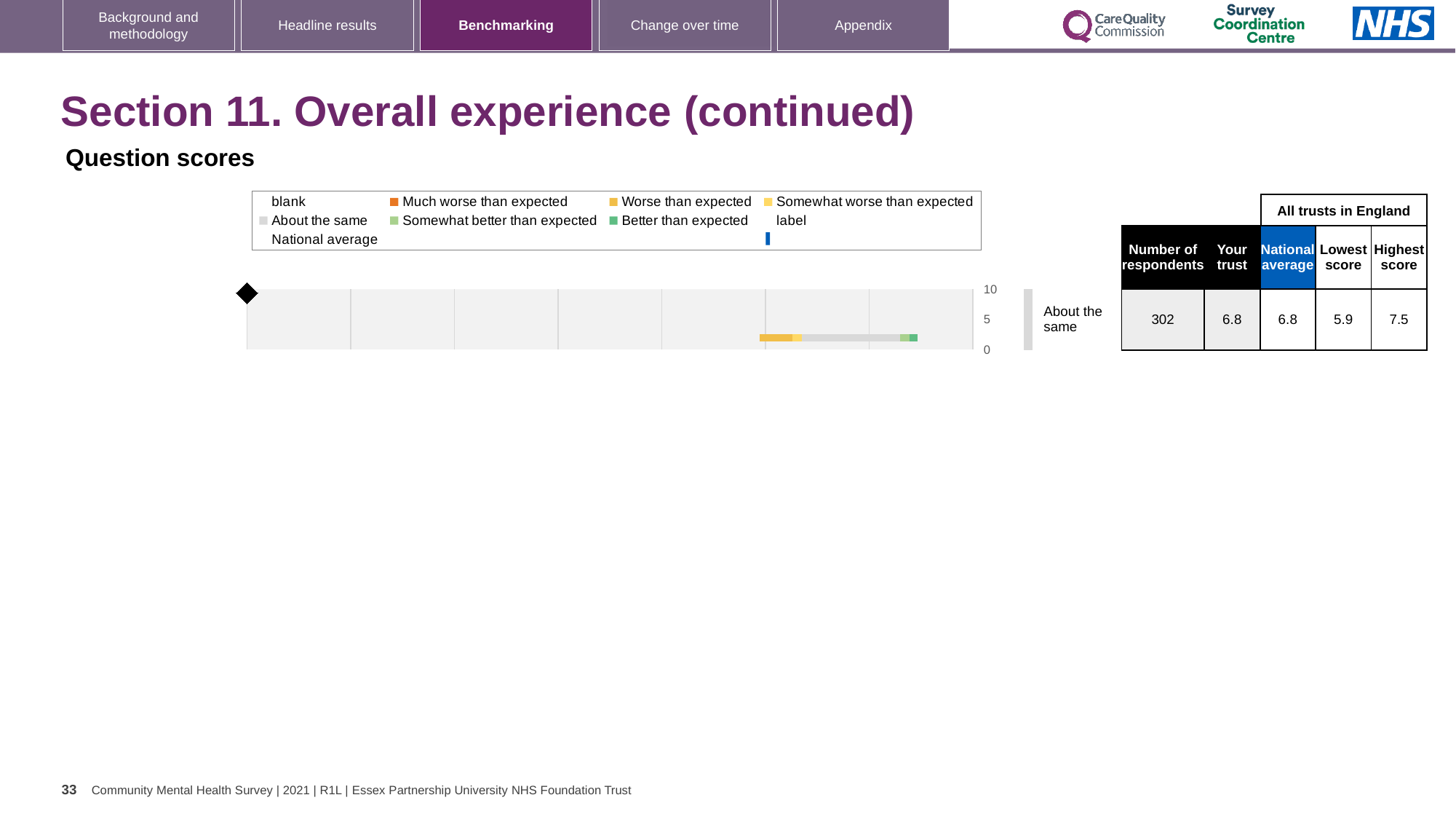
What is the national average score shown in the table? 6.8 What is the lowest score among all trusts in England shown in the table? 5.9 What is the 'Your trust' score shown for the question rated 'About the same'? 6.8 What is the difference between the highest score and the lowest score for all trusts in England? 1.6 How many question rows are plotted in the chart? 1 What is the maximum value shown on the chart's score axis? 10 What benchmark category label is given to the trust's score in the chart? About the same What kind of chart is used to show the question score? Bar chart Is the 'Your trust' score greater or less than 5? greater What is the number of respondents shown for the 'About the same' question score? 302 What is the highest score among all trusts in England shown in the table? 7.5 Which is larger, the highest score for all trusts in England or the 'Your trust' score? Highest score